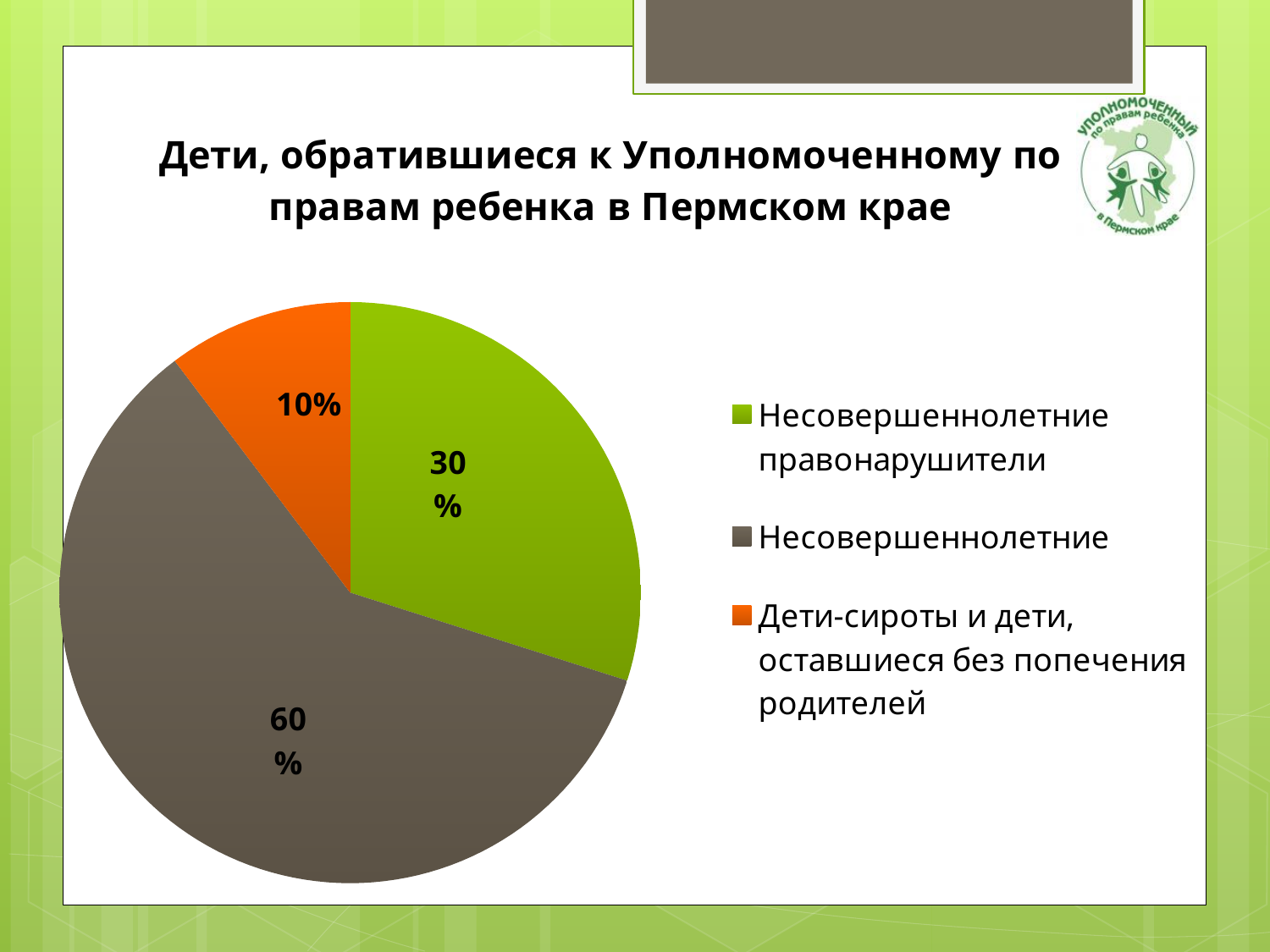
Which slice is larger: "Несовершеннолетние правонарушители" or "Дети-сироты и дети, оставшиеся без попечения родителей"? Несовершеннолетние правонарушители What share of the pie is labelled "Дети-сироты и дети, оставшиеся без попечения родителей"? 10% What kind of chart is shown on the slide? pie chart How many entries does the legend list? 3 What is the difference in percentage points between the "Несовершеннолетние" slice and the "Несовершеннолетние правонарушители" slice? 30 What share of the pie is labelled "Несовершеннолетние правонарушители"? 30% Which category has the largest slice of the pie? Несовершеннолетние Which category has the smallest slice of the pie? Дети-сироты и дети, оставшиеся без попечения родителей What share of the pie is labelled "Несовершеннолетние"? 60% How many slices does the pie chart have? 3 What is the title of the chart? Дети, обратившиеся к Уполномоченному по правам ребенка в Пермском крае What colour is the slice for "Дети-сироты и дети, оставшиеся без попечения родителей"? orange